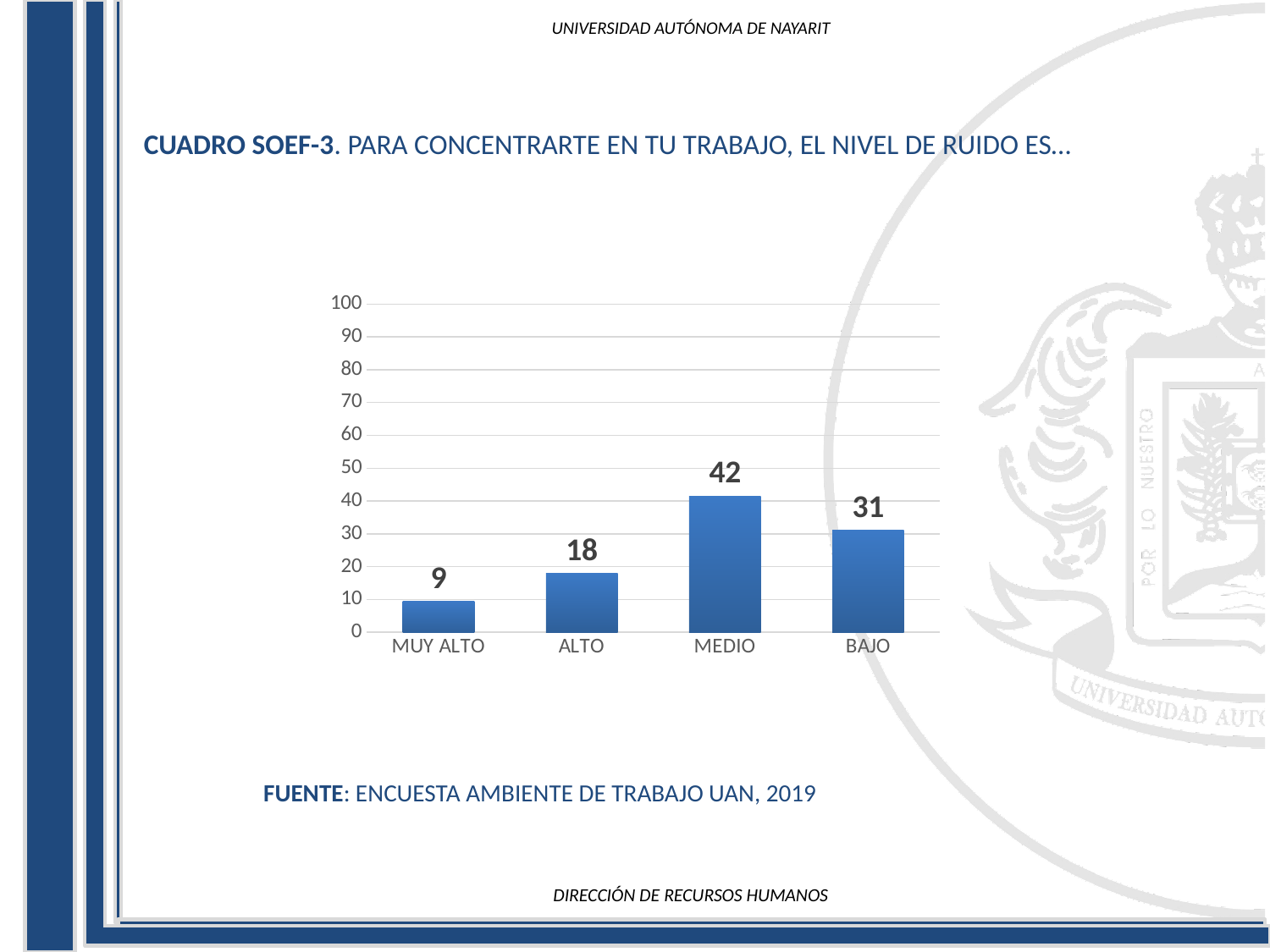
What is the value for MEDIO? 42 What kind of chart is shown on the slide? bar chart How many categories are shown on the x axis? 4 What is the difference between the values for MEDIO and BAJO? 11 Is the value for MEDIO greater or less than 50? less Which category has the highest value? MEDIO What is the source cited below the chart? ENCUESTA AMBIENTE DE TRABAJO UAN, 2019 Which is larger, the value for ALTO or the value for BAJO? BAJO Which category has the lowest value? MUY ALTO What is the value for BAJO? 31 What is the value for MUY ALTO? 9 What is the difference between the values for ALTO and MUY ALTO? 9